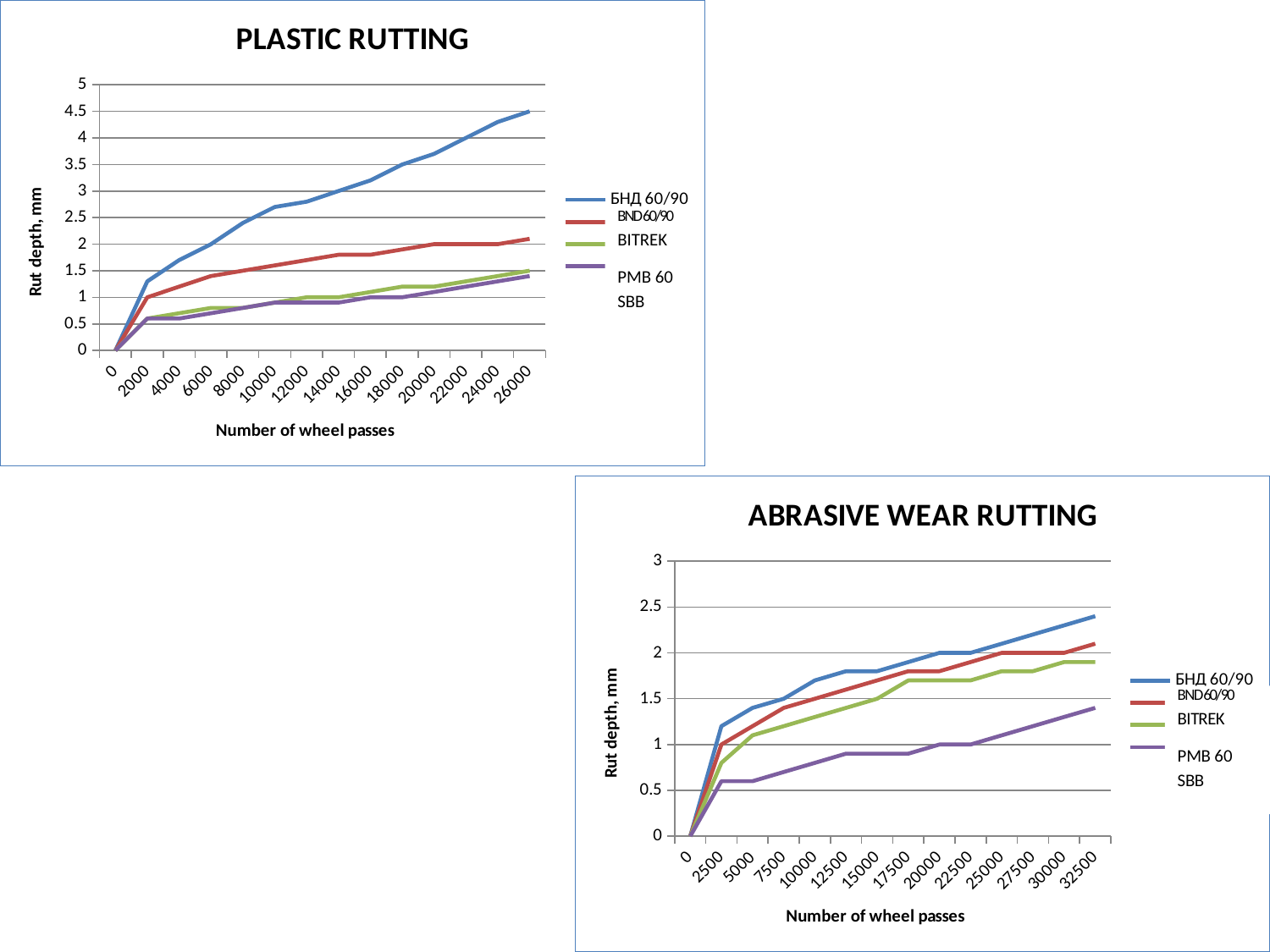
How many lines are plotted in the PLASTIC RUTTING chart? 4 What kind of chart is the PLASTIC RUTTING chart? line chart In the ABRASIVE WEAR RUTTING chart, which series has the highest rut depth at 32500 wheel passes? БНД 60/90 What is the y-axis title of the ABRASIVE WEAR RUTTING chart? Rut depth, mm In the PLASTIC RUTTING chart, is the value for БНД 60/90 at 10000 wheel passes greater or less than 2? greater In the PLASTIC RUTTING chart, which series has the highest rut depth at 26000 wheel passes? БНД 60/90 What kind of chart is the ABRASIVE WEAR RUTTING chart? line chart How many points are labelled on the x axis of the ABRASIVE WEAR RUTTING chart? 14 In the ABRASIVE WEAR RUTTING chart, is the value for БНД 60/90 at 2500 wheel passes greater or less than 1? greater In the PLASTIC RUTTING chart, do the rut depth values rise or fall as the number of wheel passes increases? rise In the PLASTIC RUTTING chart, is the value for БНД 60/90 at 26000 wheel passes greater or less than 4? greater